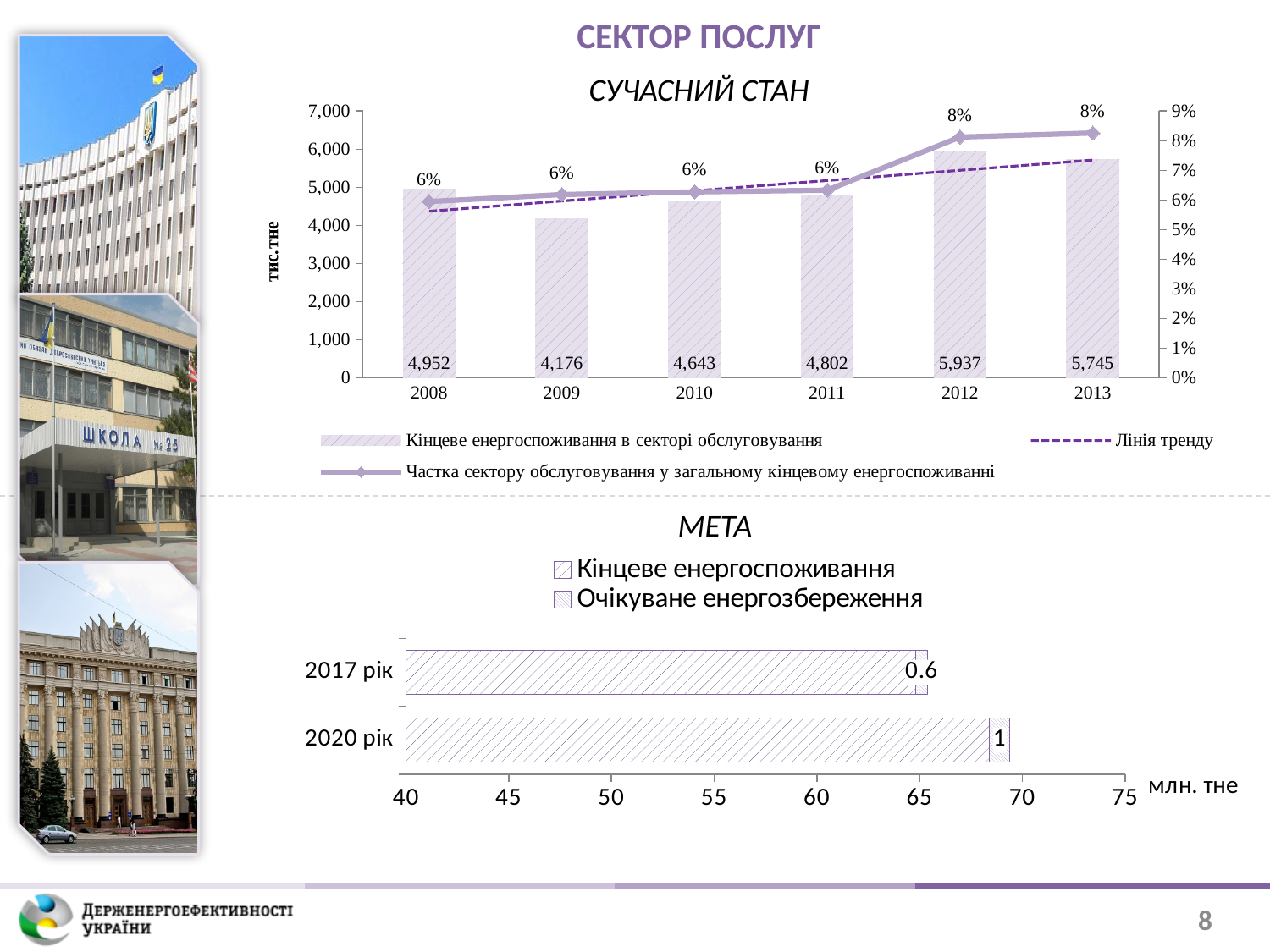
In the МЕТА chart, what is the expected energy saving for 2017 рік? 0.6 In the СУЧАСНИЙ СТАН chart, which year has the lowest final energy consumption? 2009 In the СУЧАСНИЙ СТАН chart, which year has the highest final energy consumption? 2012 How many years are shown on the x axis of the СУЧАСНИЙ СТАН chart? 6 How many entries does the legend of the СУЧАСНИЙ СТАН chart list? 3 What kind of chart is the МЕТА chart? bar chart In the СУЧАСНИЙ СТАН chart, what is the difference in final energy consumption between 2012 and 2013? 192 In the СУЧАСНИЙ СТАН chart, what is the final energy consumption in the services sector in 2009? 4,176 In the СУЧАСНИЙ СТАН chart, is the final energy consumption higher in 2010 or in 2011? 2011 In the МЕТА chart, what is the expected energy saving for 2020 рік? 1 In the СУЧАСНИЙ СТАН chart, what is the final energy consumption in the services sector in 2012? 5,937 In the СУЧАСНИЙ СТАН chart, what is the share of the services sector in total final energy consumption in 2013? 8%